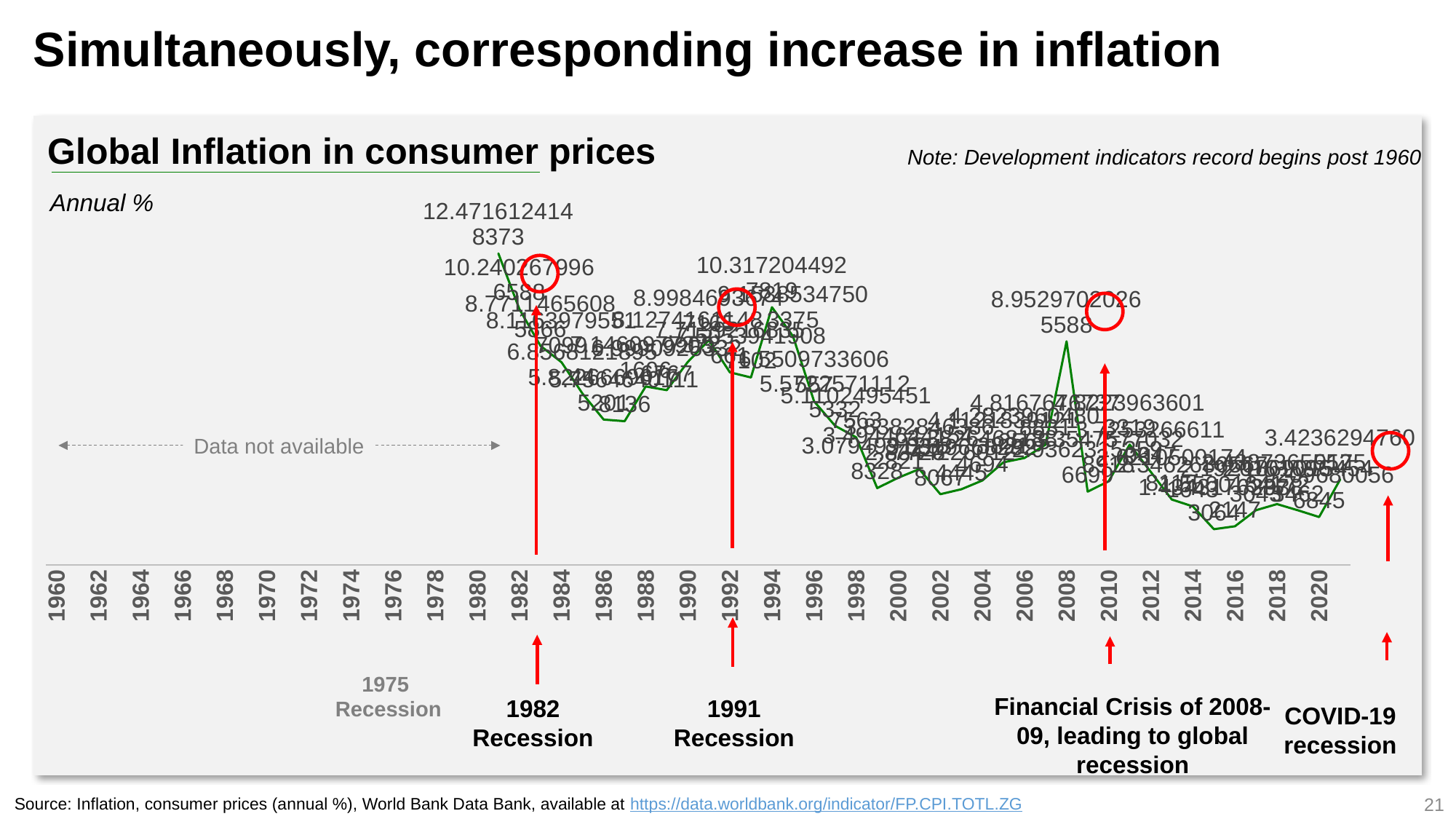
What kind of chart is shown on the slide? Line chart What is the title of the chart? Global Inflation in consumer prices In what unit are the values on the chart expressed? Annual % In which decade does the highest point of the inflation line occur? 1980s Does the inflation line rise or fall between 1994 and 2002? Fall Which year has the higher inflation value, 1982 or 2016? 1982 How many recession events are labelled below the x axis? 5 Does the inflation line rise or fall between 2008 and 2010? Fall What is the first year shown on the x axis? 1960 Which year has the higher inflation value, 2008 or 2015? 2008 What is the last year labelled on the x axis? 2020